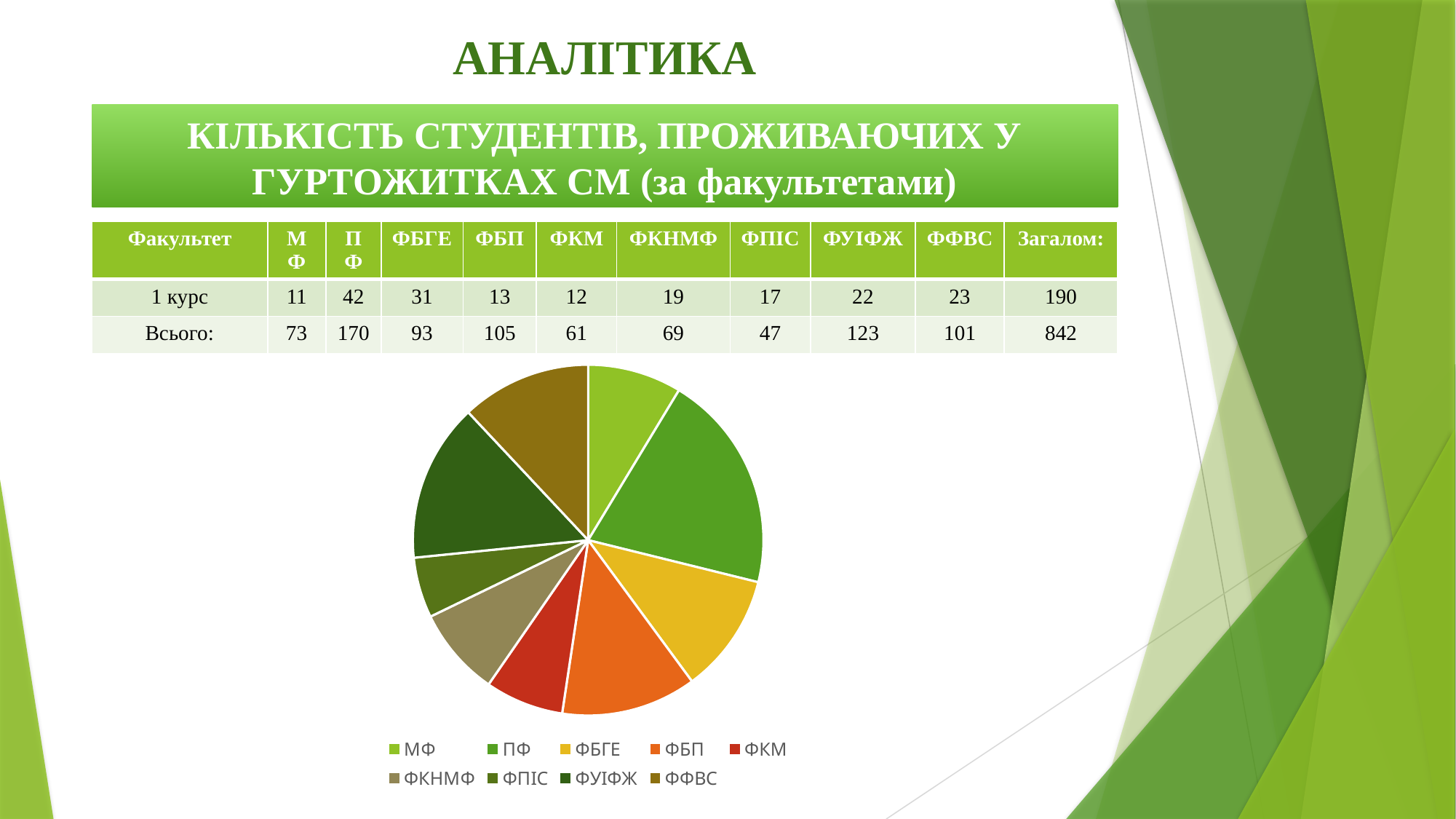
Which faculty has the largest slice in the pie chart? ПФ In the pie chart, which slice is larger: ПФ or ФБГЕ? ПФ What kind of chart is shown on the slide? pie chart How many slices does the pie chart have? 9 Where is the legend positioned relative to the pie chart? below the chart Which legend entry is listed first in the pie chart's legend? МФ In the pie chart, which slice is larger: ФУІФЖ or ФКНМФ? ФУІФЖ In the pie chart, which slice is larger: МФ or ПФ? ПФ How many entries does the pie chart's legend list? 9